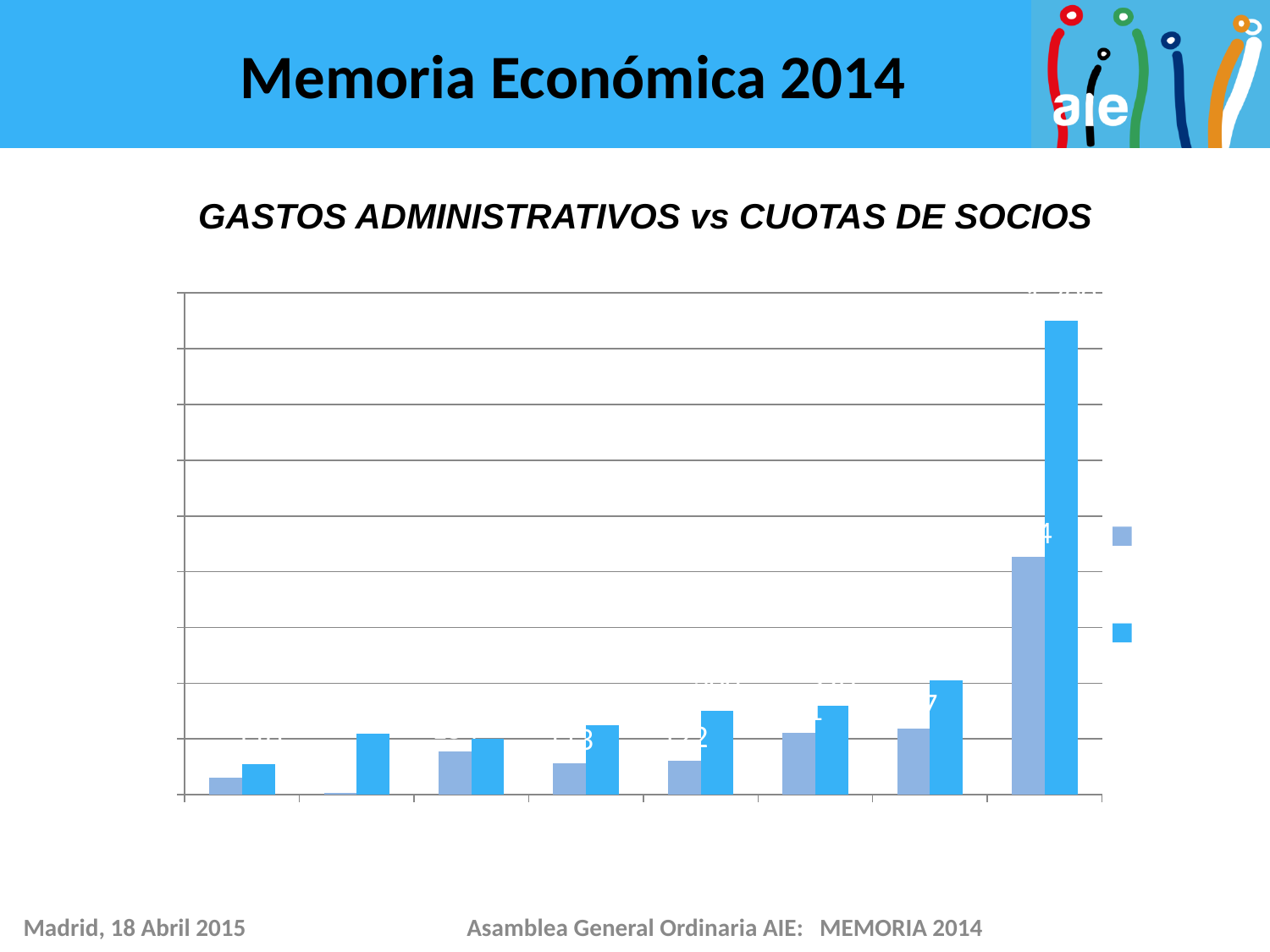
How many series does the chart's legend list? 2 Which category group contains the tallest bar in the chart, the leftmost or the rightmost? the rightmost What is the title of the chart on the slide? GASTOS ADMINISTRATIVOS vs CUOTAS DE SOCIOS In the rightmost category group, which bar is taller, the lighter blue bar or the darker blue bar? the darker blue bar Which category group has the shortest lighter blue bar, the second from the left or the rightmost? the second from the left Do the values of the darker blue series generally rise or fall from left to right along the x axis? rise How many category groups of bars are plotted in the chart? 8 What kind of chart is shown on the slide? bar chart In the second category group from the left, which bar is taller, the lighter blue bar or the darker blue bar? the darker blue bar Are the bars in the chart vertical or horizontal? vertical